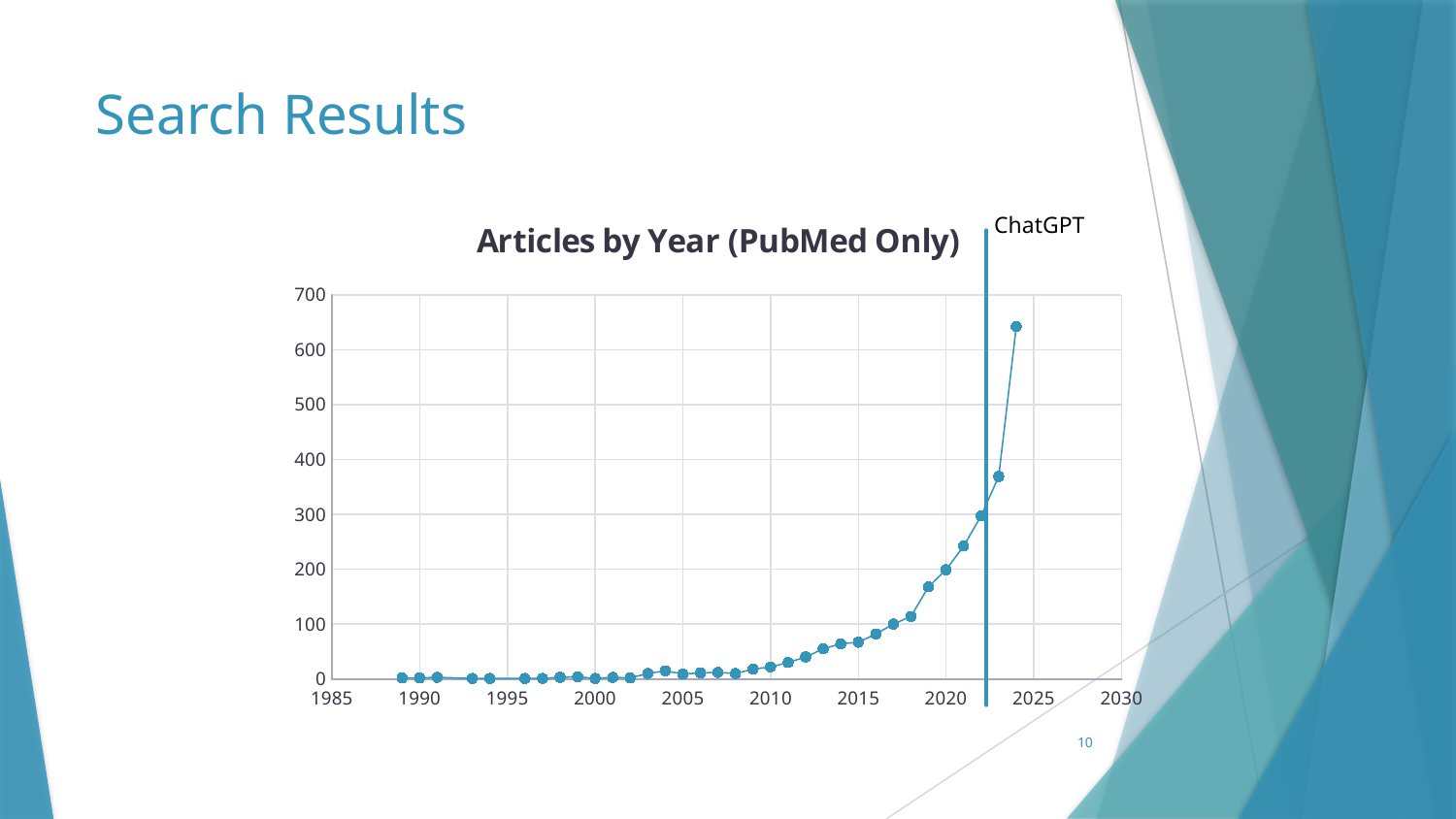
Is the value for 2023 greater or less than 400? less Do the values generally rise or fall as the years increase along the x axis? rise Which year has more articles, 2024 or 2023? 2024 What label is attached to the vertical line drawn on the chart? ChatGPT Is the value for 2015 greater or less than 100? less What is the title of the chart? Articles by Year (PubMed Only) What kind of chart is shown on the slide? line chart Is the value for 2010 greater or less than 100? less Which year has the highest number of articles? 2024